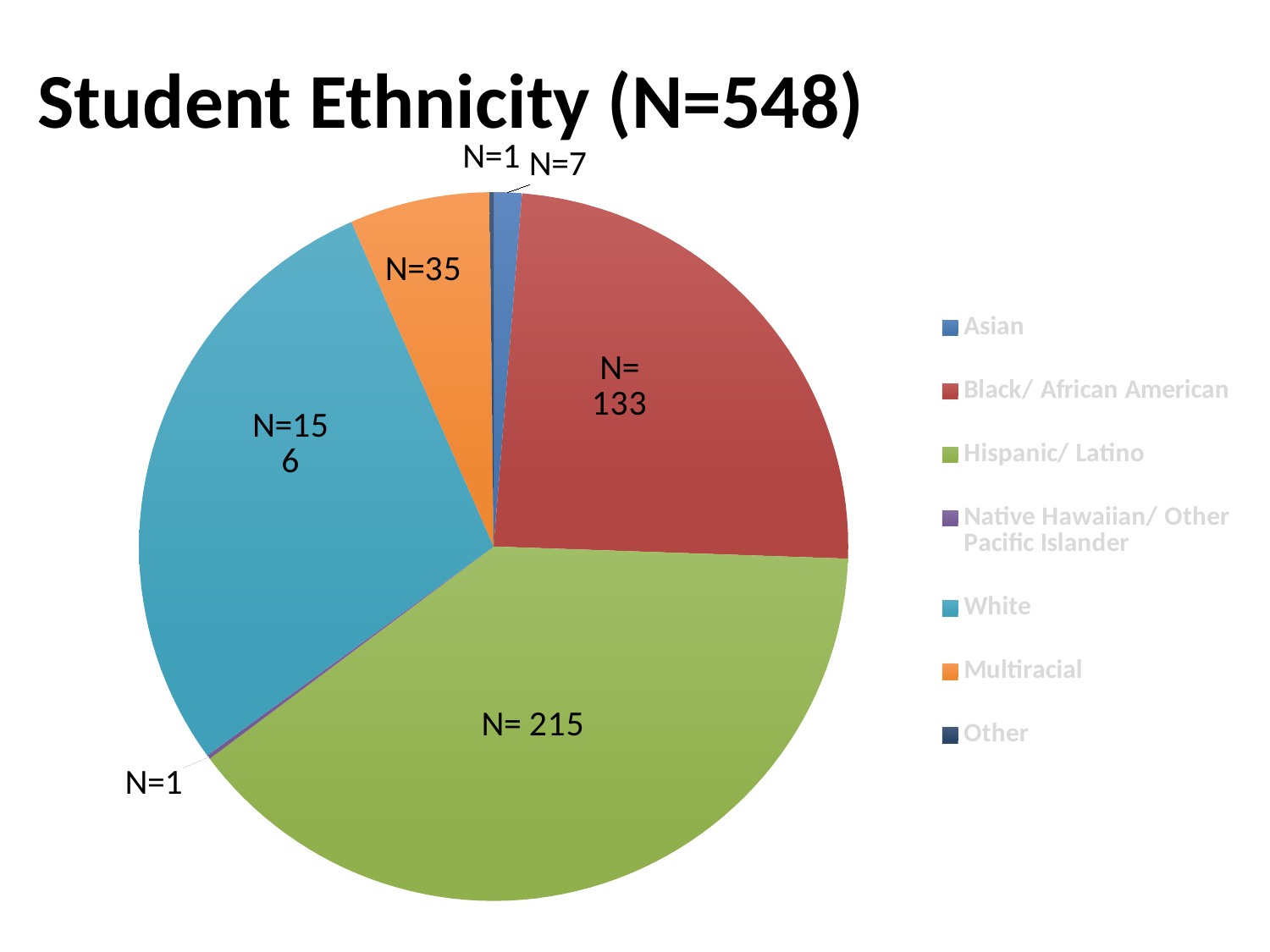
Which is larger, the N value for White students or for Multiracial students? White What is the N value for Hispanic/ Latino students? 215 What is the N value for Multiracial students? 35 What is the difference between the N values for Hispanic/ Latino and Black/ African American students? 82 How many ethnicity categories does the legend list? 7 What is the total N given in the chart title? 548 What is the N value for Black/ African American students? 133 What kind of chart is shown on the slide? pie chart What is the N value for White students? 156 What is the N value for Asian students? 7 What is the difference between the N values for White and Black/ African American students? 23 Which ethnicity category has the largest slice of the pie? Hispanic/ Latino